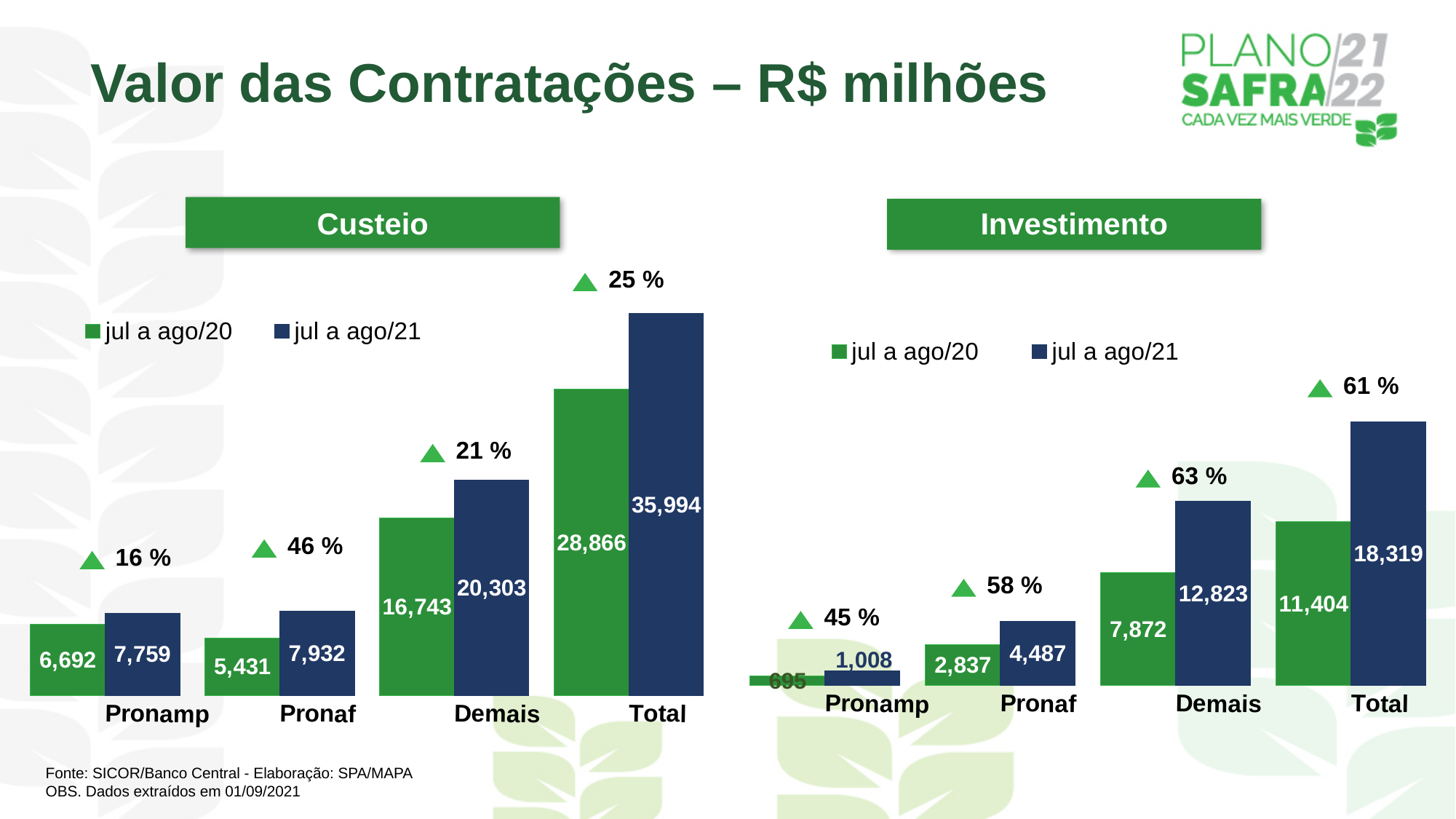
In the Investimento chart, what is the value for Pronamp in jul a ago/21? 1,008 In the Investimento chart, what is the value for Pronaf in jul a ago/20? 2,837 In the Investimento chart, which category has the lowest value for jul a ago/20? Pronamp In the Custeio chart, what is the difference between the jul a ago/21 and jul a ago/20 values for Pronaf? 2,501 What kind of chart is the Investimento chart? Bar chart How many series does the legend of the Investimento chart list? 2 In the Custeio chart, what is the value for Demais in jul a ago/21? 20,303 In the Custeio chart, what is the Total value for jul a ago/20? 28,866 In the Custeio chart, which is larger: Pronamp in jul a ago/21 or Pronaf in jul a ago/21? Pronaf in jul a ago/21 In the Custeio chart, excluding Total, which category has the highest value for jul a ago/21? Demais How many categories are shown on the x axis of the Custeio chart? 4 In the Investimento chart, what is the difference between the jul a ago/21 and jul a ago/20 values for Demais? 4,951